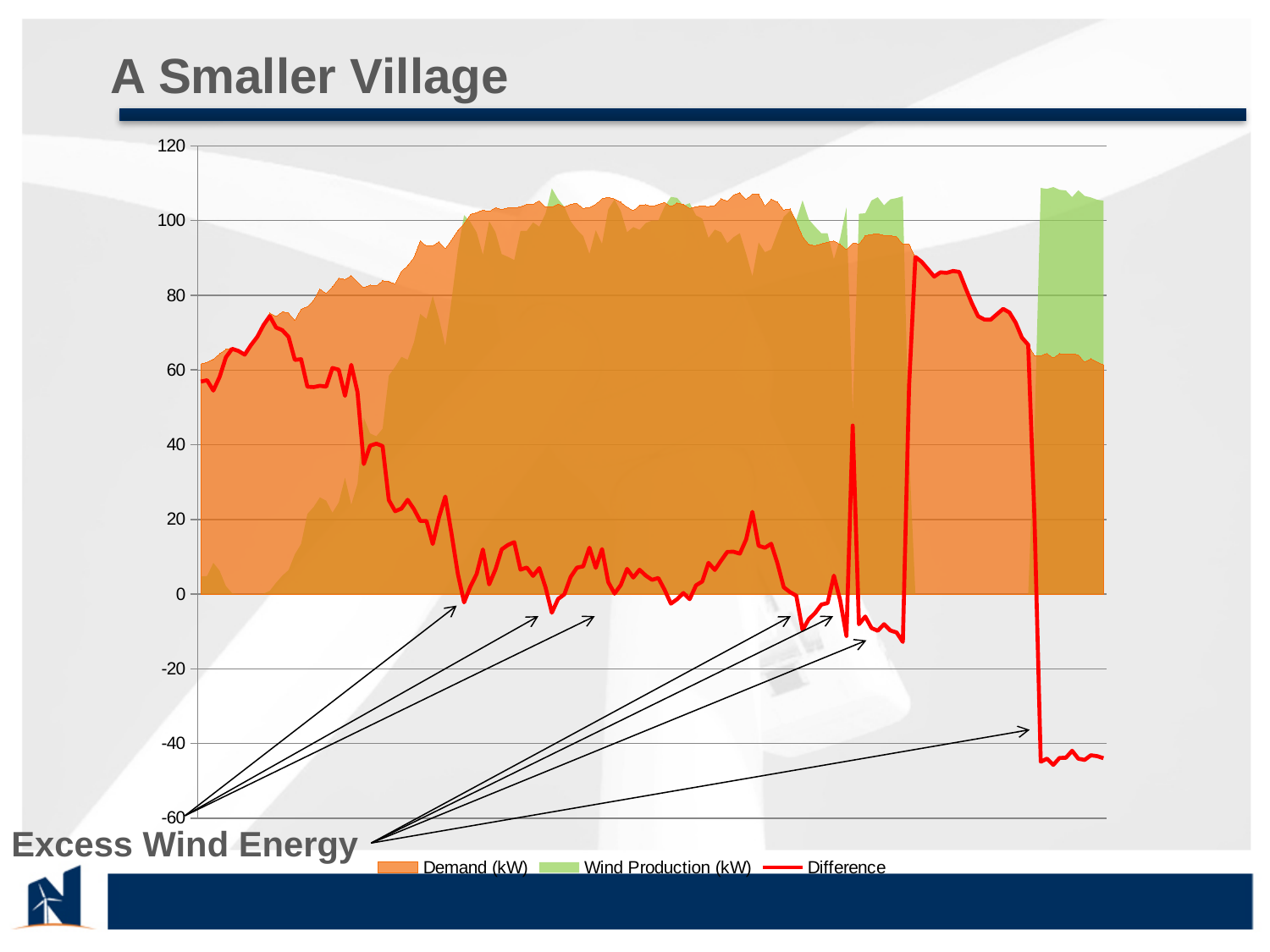
What is the lowest value shown on the chart's vertical axis? -60 What colour is the Wind Production (kW) series in the chart? Green Which series in the chart is drawn as a red line rather than a filled area? Difference What are the three series named in the chart legend? Demand (kW), Wind Production (kW), Difference At the far right end of the chart, is the Difference value greater or less than -20? less At the far left end of the chart, is the Difference value greater or less than 20? greater How many series does the chart legend list? 3 At the far left end of the chart, is the Demand (kW) value greater or less than 40? greater At the far right end of the chart, which is larger, Wind Production (kW) or Demand (kW)? Wind Production (kW) Does the Difference line overall rise or fall from the left end of the chart to the right end? fall